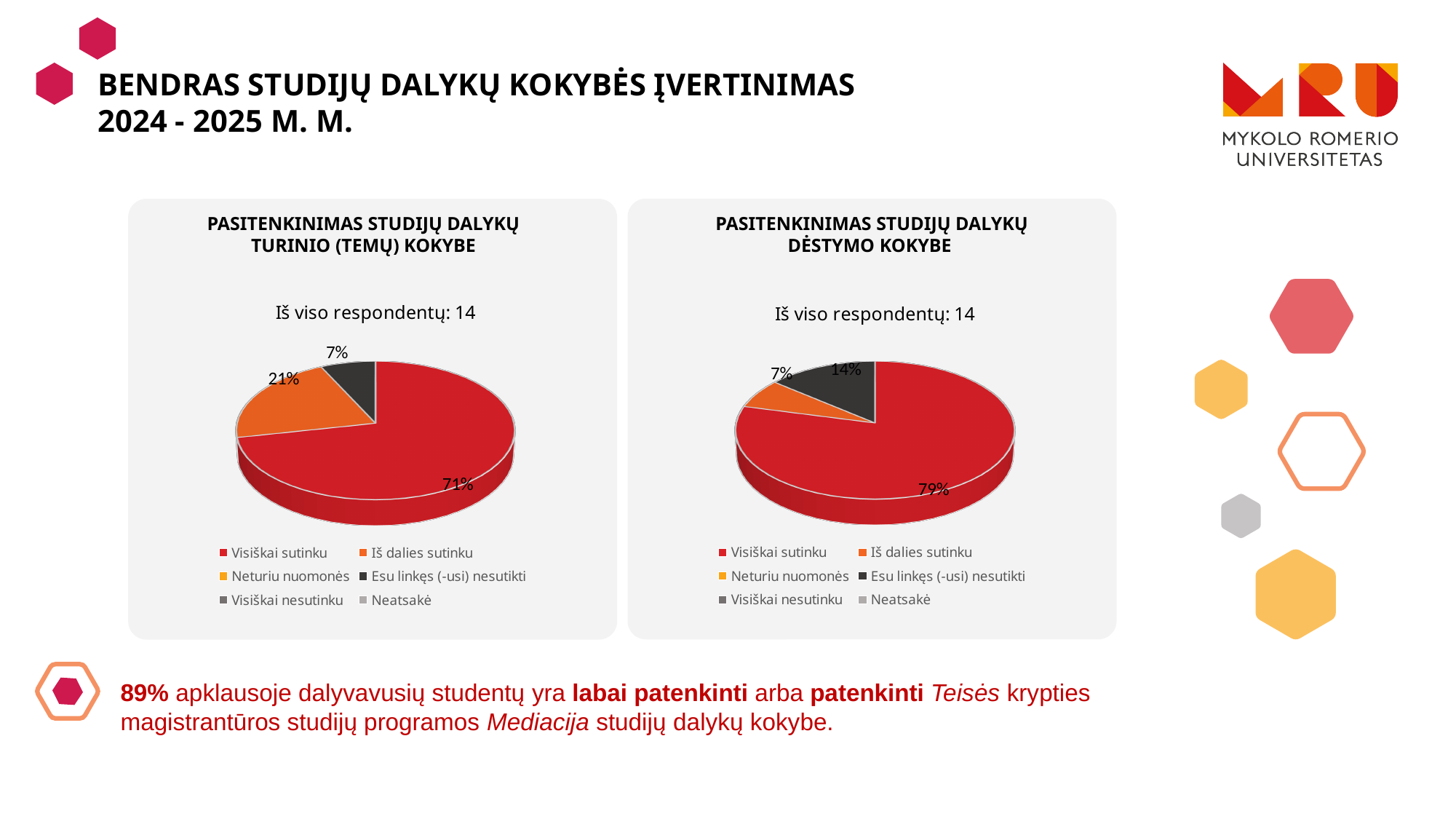
How many respondents are reported for the right chart (Pasitenkinimas studijų dalykų dėstymo kokybe)? 14 In the left chart (Pasitenkinimas studijų dalykų turinio (temų) kokybe), which response has the largest slice? Visiškai sutinku What type of chart is used on the left (Pasitenkinimas studijų dalykų turinio (temų) kokybe)? Pie chart In the right chart (Pasitenkinimas studijų dalykų dėstymo kokybe), what share of respondents chose 'Visiškai sutinku'? 79% In the left chart (Pasitenkinimas studijų dalykų turinio (temų) kokybe), what share of respondents chose 'Visiškai sutinku'? 71% In the right chart (Pasitenkinimas studijų dalykų dėstymo kokybe), what share of respondents chose 'Iš dalies sutinku'? 7% What is the difference between the 'Visiškai sutinku' share in the right chart (79%) and in the left chart (71%)? 8 percentage points In the right chart (Pasitenkinimas studijų dalykų dėstymo kokybe), what share of respondents chose 'Esu linkęs (-usi) nesutikti'? 14% In the left chart (Pasitenkinimas studijų dalykų turinio (temų) kokybe), what share of respondents chose 'Iš dalies sutinku'? 21% Which chart has the larger 'Iš dalies sutinku' share, the left chart (turinio kokybe) or the right chart (dėstymo kokybe)? The left chart (turinio kokybe) In the left chart (Pasitenkinimas studijų dalykų turinio (temų) kokybe), what share of respondents chose 'Esu linkęs (-usi) nesutikti'? 7% In the right chart (Pasitenkinimas studijų dalykų dėstymo kokybe), which response has the smallest slice? Iš dalies sutinku